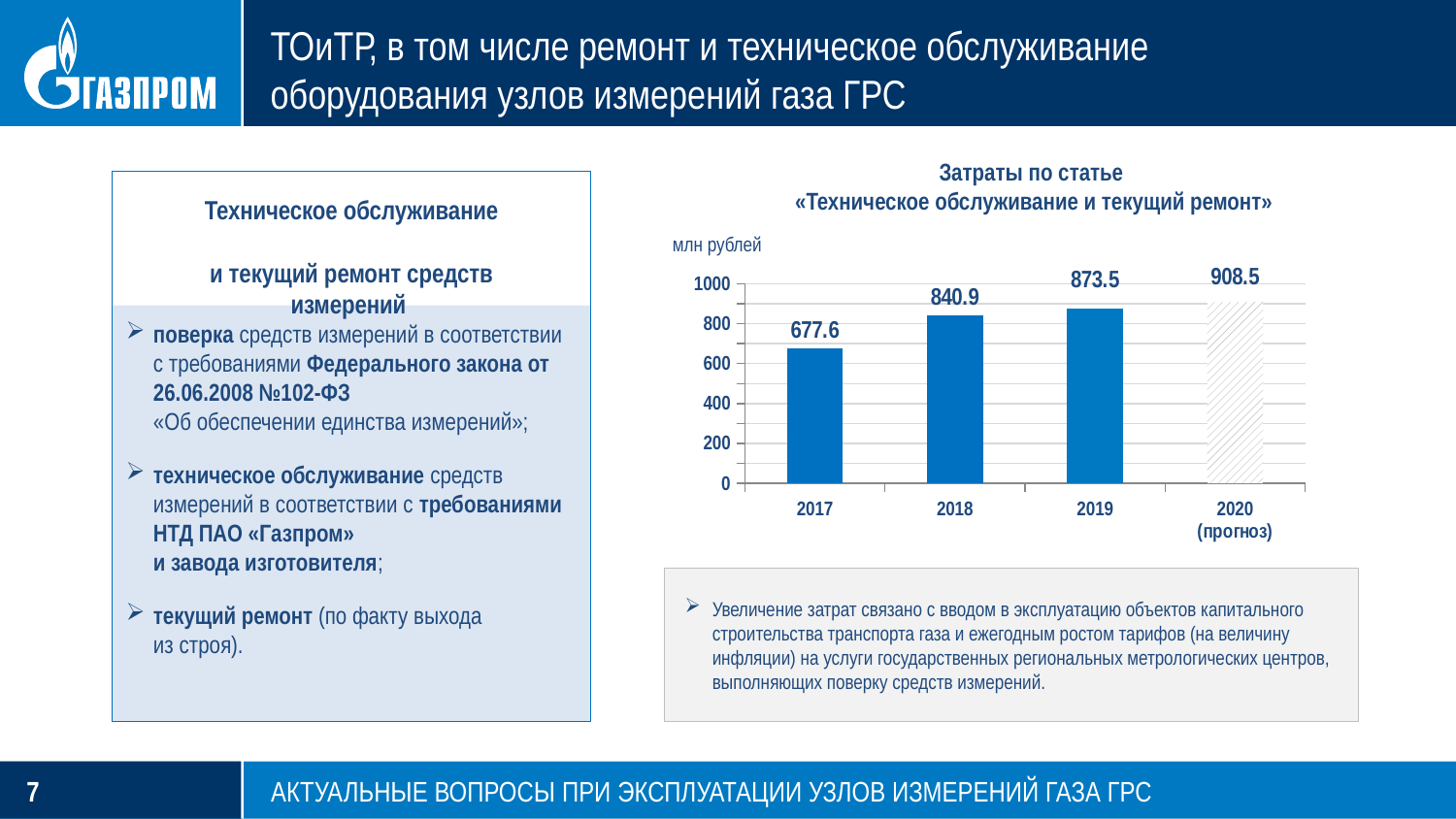
What is the value for 2019? 873.5 Which year has the highest value? 2020 (прогноз) What is the difference between the values for 2020 (прогноз) and 2019? 35.0 How many years are shown on the x axis? 4 Which year has the lowest value? 2017 What is the value for 2017? 677.6 What is the forecast value for 2020 (прогноз)? 908.5 Which is larger, the value for 2018 or the value for 2019? 2019 What is the difference between the values for 2018 and 2017? 163.3 What is the value for 2018? 840.9 Do the values rise or fall from 2017 to 2020? rise What kind of chart is this? bar chart